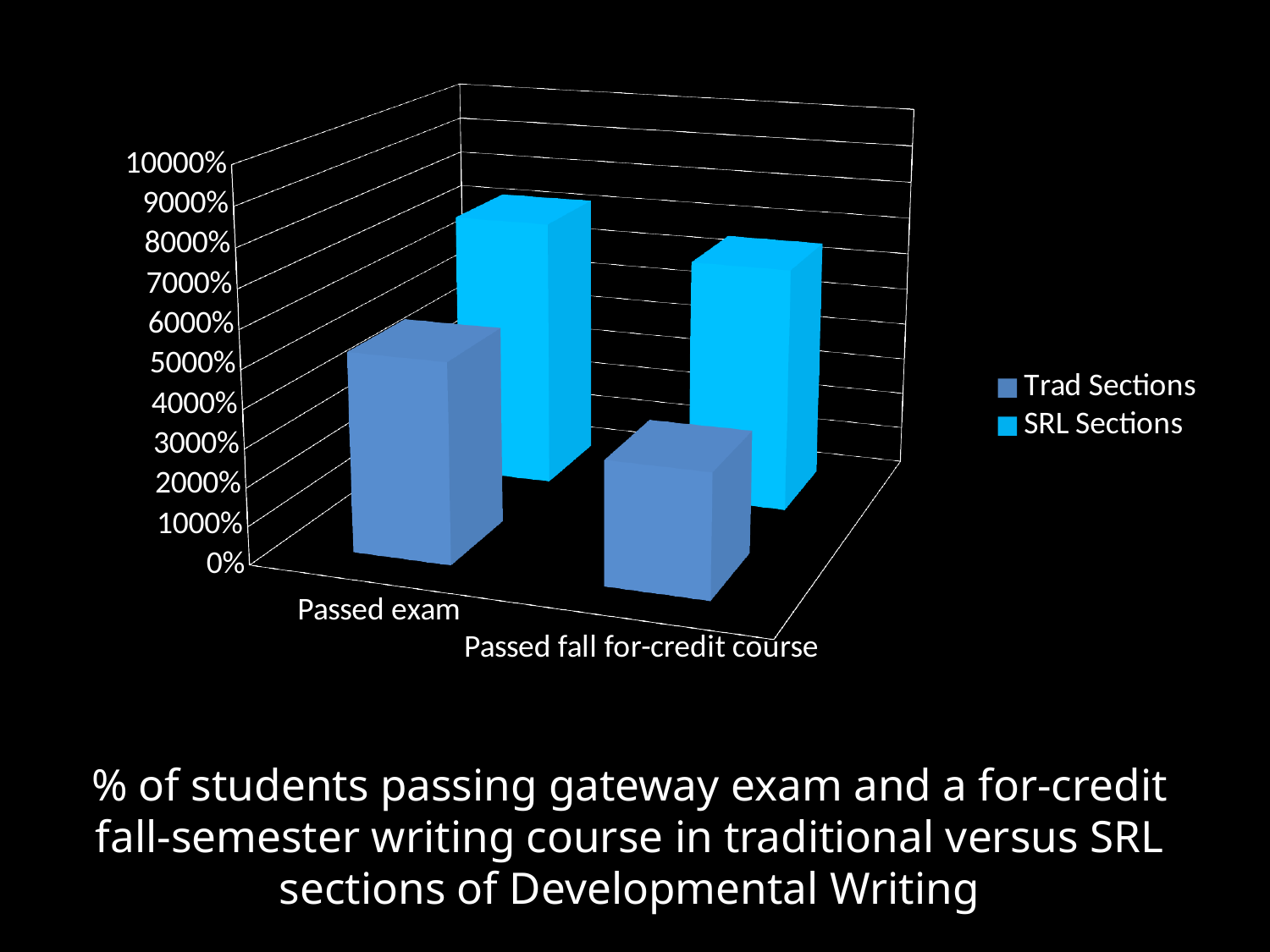
Is the SRL Sections value for Passed fall for-credit course greater or less than 9000%? less Is the SRL Sections value for Passed exam greater or less than 5000%? greater What kind of chart is shown on the slide? bar chart Which series is listed first in the legend? Trad Sections For Passed fall for-credit course, which series has the larger value, Trad Sections or SRL Sections? SRL Sections Is the Trad Sections value for Passed fall for-credit course greater or less than 5000%? less Which category has the lowest value for Trad Sections? Passed fall for-credit course How many categories are shown on the x axis? 2 How many series does the legend list? 2 Which series is shown in the lighter cyan colour? SRL Sections For Passed exam, which series has the larger value, Trad Sections or SRL Sections? SRL Sections